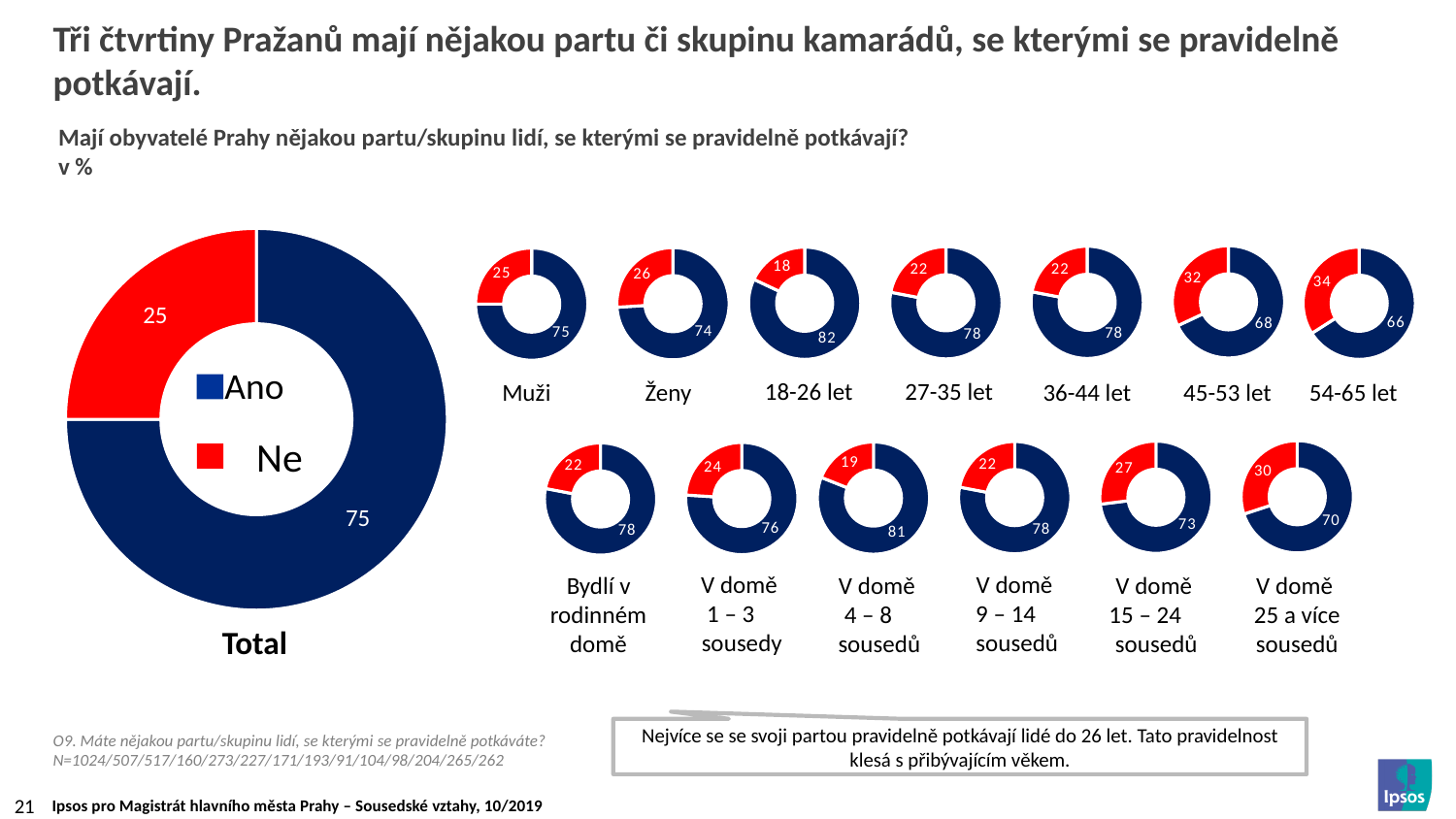
Which is larger: the Ne value in the Muži chart or the Ne value in the 45-53 let chart? 45-53 let In the 18-26 let donut chart, what is the value for Ano? 82 Among the age-group donut charts (18-26 let to 54-65 let), which age group has the lowest Ano value? 54-65 let What is the difference between the Ano value in the 18-26 let chart and the Ano value in the 54-65 let chart? 16 In the V domě 4 – 8 sousedů donut chart, what is the value for Ano? 81 In the 54-65 let donut chart, what is the value for Ne? 34 What type of chart is the Total chart? Donut chart How many series does the legend of the Total chart list? 2 In the Total chart, which colour represents Ne? Red In the Total donut chart, what is the value for Ne? 25 In the Total donut chart, what is the value for Ano? 75 Among the age-group donut charts (18-26 let to 54-65 let), which age group has the highest Ano value? 18-26 let